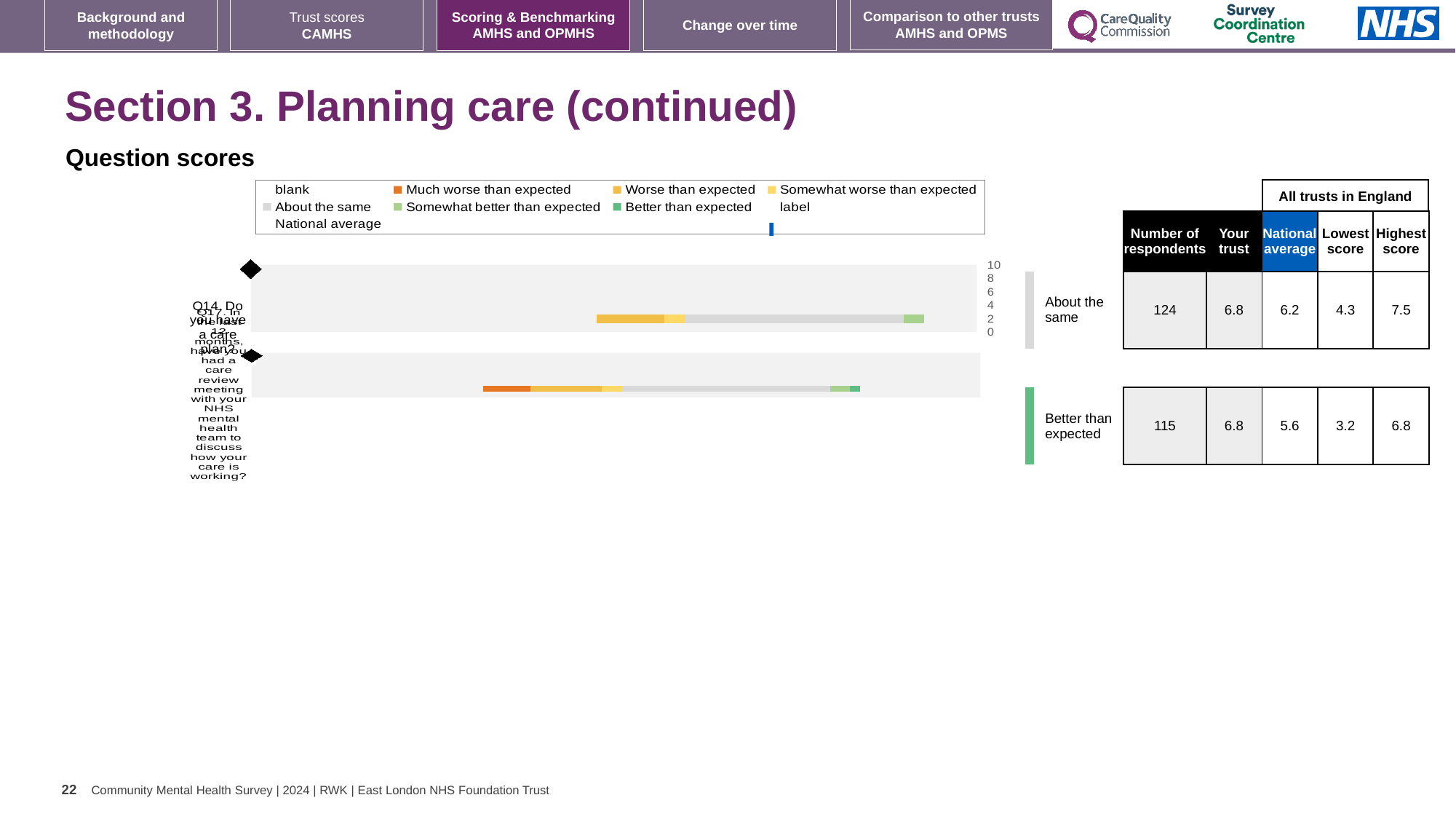
In the table beside the chart, what is the number of respondents for the 'About the same' row (Q14)? 124 Which question's bar is labelled 'About the same' beside the chart? Q14 What is the highest value shown on the chart's numeric axis? 10 In the table beside the chart, what is the 'Your trust' score for the 'Better than expected' row (Q17)? 6.8 What colour does the legend use for 'About the same'? grey In the table beside the chart, which row has the higher national average, 'About the same' (Q14) or 'Better than expected' (Q17)? About the same (Q14) What colour does the legend use for 'Much worse than expected'? orange What kind of chart is used to show the question scores on this slide? bar chart How many question bars are plotted in the question scores chart? 2 In the table beside the chart, what is the difference between the highest score and the lowest score for the 'About the same' row (Q14)? 3.2 In the table beside the chart, what is the national average for the 'Better than expected' row (Q17)? 5.6 Which question's bar is labelled 'Better than expected' beside the chart? Q17